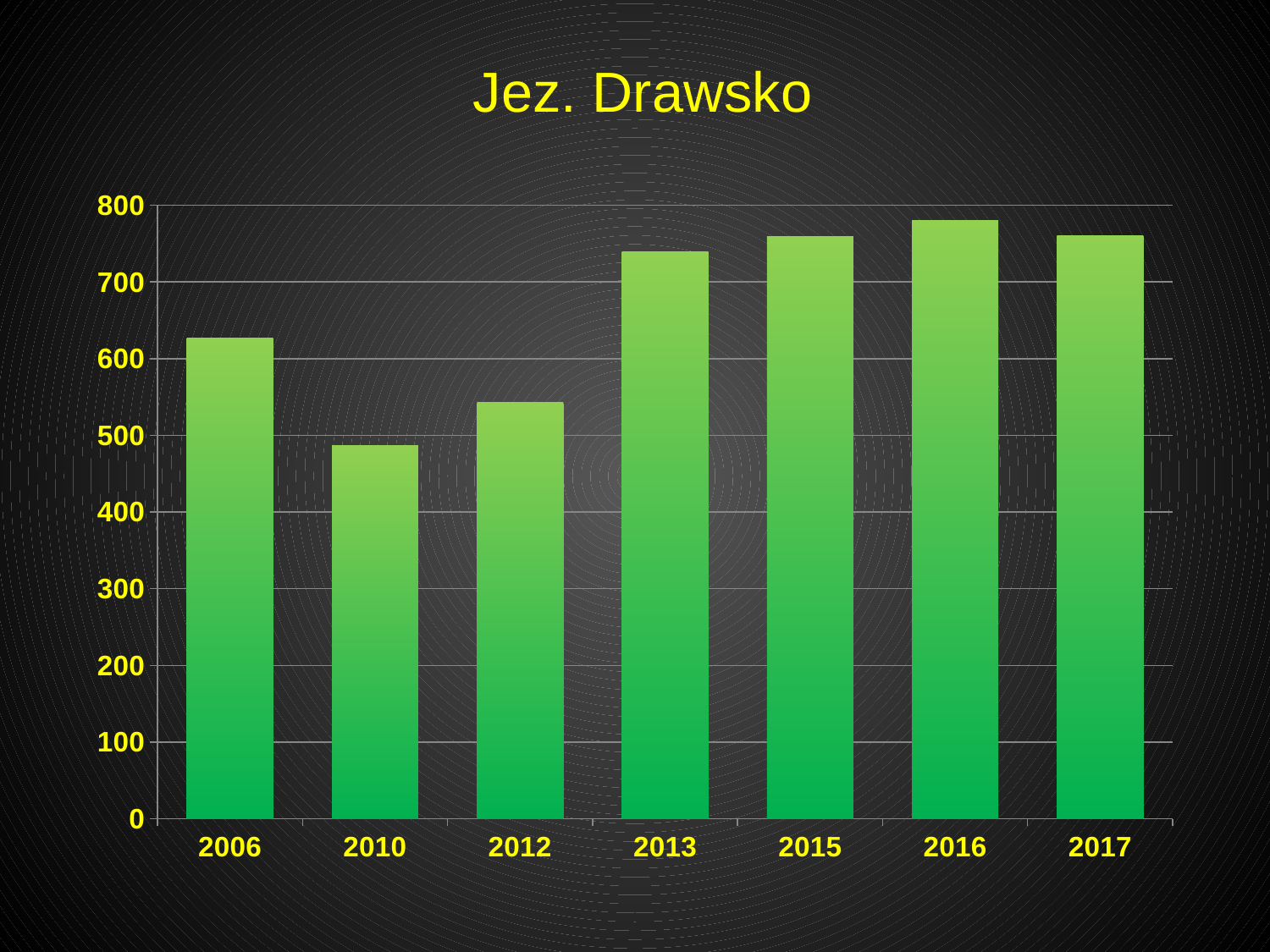
What type of chart is shown on the slide? bar chart Which year has the larger value, 2006 or 2010? 2006 Is the value for 2010 greater or less than 500? less Is the value for 2012 greater or less than 500? greater How many years are shown on the x axis of the chart? 7 Is the value for 2013 greater or less than 700? greater Which year has the lowest bar in the chart? 2010 Do the values rise or fall from 2010 to 2016? rise What is the title of the chart? Jez. Drawsko Which year has the highest bar in the chart? 2016